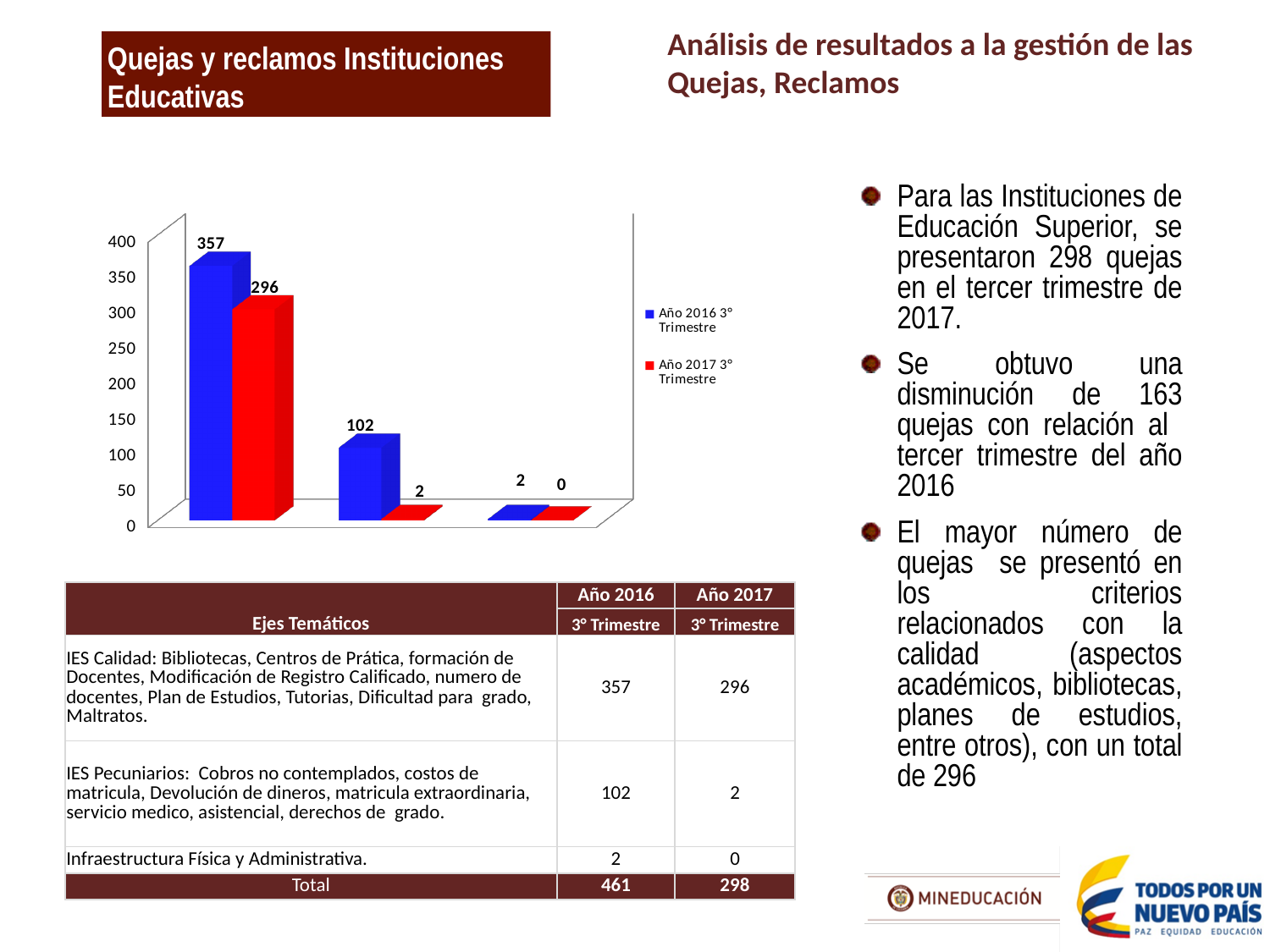
What is the difference between the Año 2016 3° Trimestre and Año 2017 3° Trimestre bars in the first (leftmost) group? 61 In the second (middle) group of bars, which series has the larger value, Año 2016 3° Trimestre or Año 2017 3° Trimestre? Año 2016 3° Trimestre Which bar in the chart has the highest value? Año 2016 3° Trimestre in the first group (357) What is the value of the Año 2017 3° Trimestre bar in the first (leftmost) group of bars? 296 What is the value of the Año 2017 3° Trimestre bar in the third (rightmost) group of bars? 0 What type of chart is shown on the slide? bar chart How many groups of bars are plotted in the chart? 3 Which colour represents the Año 2017 3° Trimestre series in the chart? red What is the value of the Año 2016 3° Trimestre bar in the second (middle) group of bars? 102 What is the value of the Año 2016 3° Trimestre bar in the first (leftmost) group of bars? 357 What is the difference between the Año 2016 3° Trimestre and Año 2017 3° Trimestre bars in the second (middle) group? 100 How many series does the chart legend list? 2